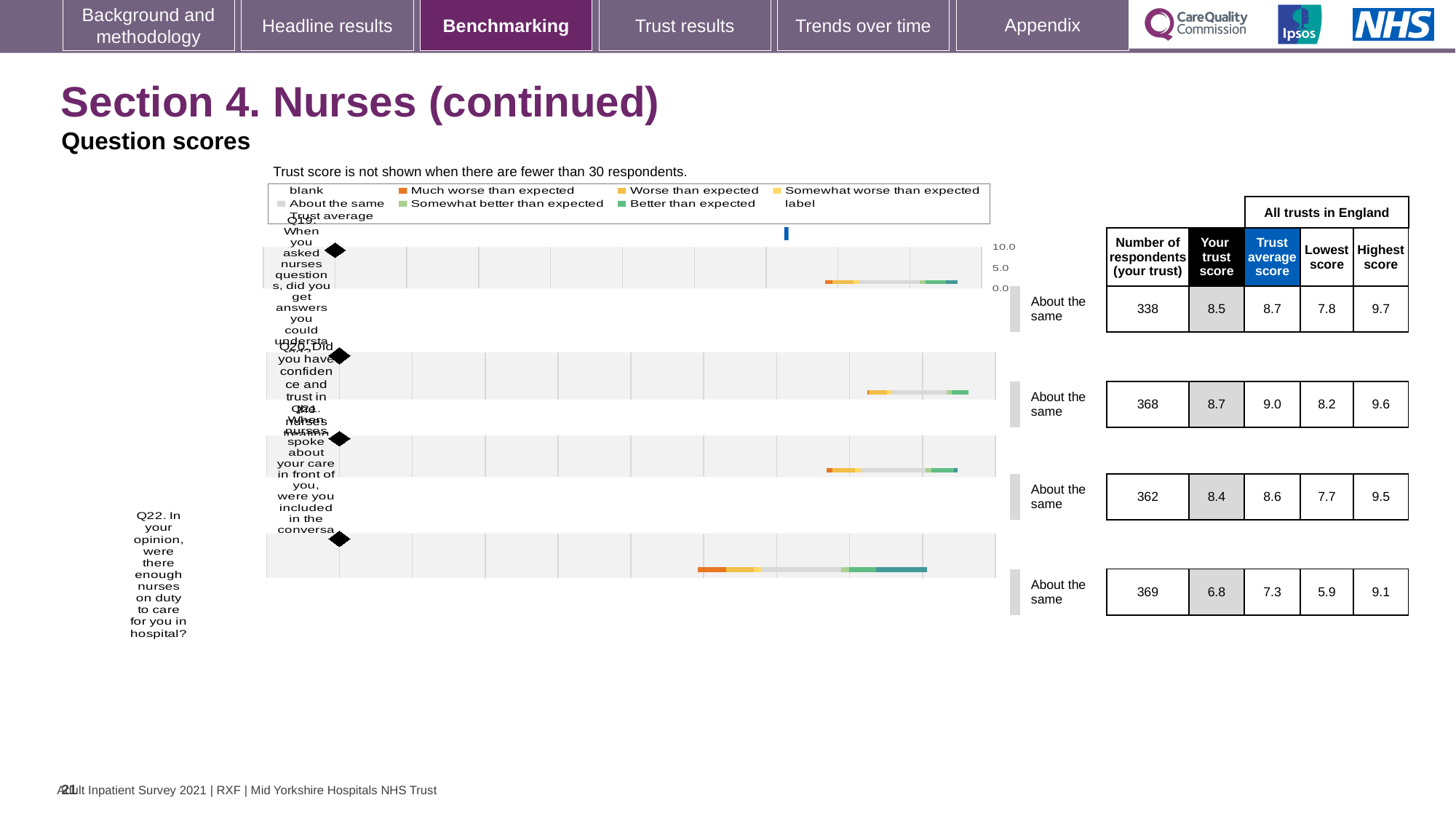
What is the highest score across all trusts in England for Q19 (did you get answers you could understand)? 9.7 Which question has the lowest 'Your trust score'? Q22 What is the difference between the trust average score and your trust score for Q22? 0.5 What benchmark category is shown for Q21 (were you included in the conversation)? About the same For Q19, which is larger: your trust score or the trust average score? Trust average score Which question has the highest 'Your trust score'? Q20 How many questions are plotted on the chart? 4 What is the 'Your trust score' value for Q22 (were there enough nurses on duty to care for you in hospital)? 6.8 What kind of chart is used to show the question scores? Bar chart How many respondents from your trust answered Q20 (confidence and trust in the nurses treating you)? 368 What is the difference between the highest and lowest scores for Q20? 1.4 What is the lowest score across all trusts in England for Q22? 5.9